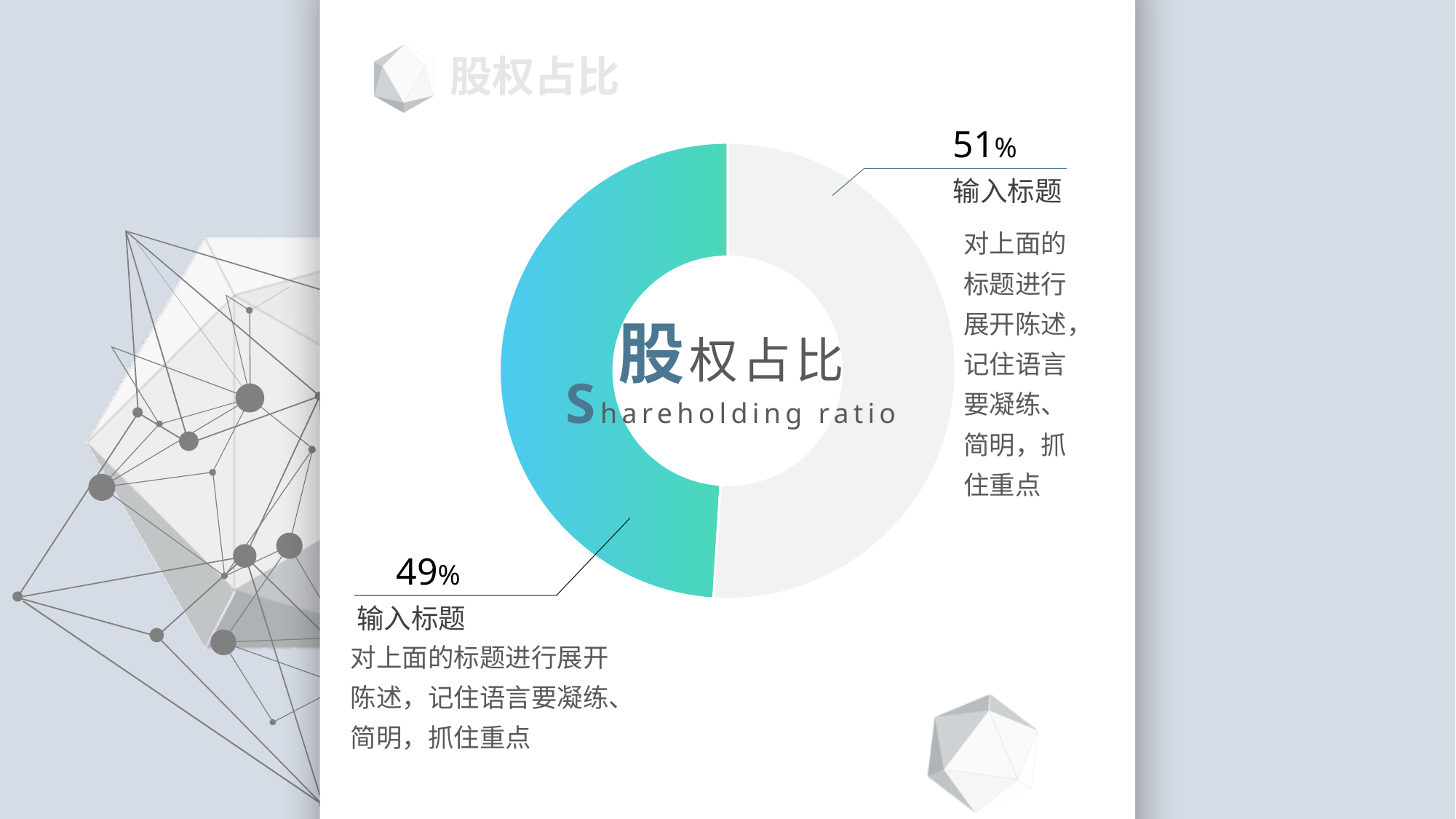
Which slice of the donut chart is larger, the grey one or the teal-blue one? The grey one What percentage is shown for the teal-blue slice on the left side of the donut chart? 49% What English text appears in the centre of the donut chart? Shareholding ratio What percentage is shown for the grey slice on the right side of the donut chart? 51% What is the difference between the two percentages shown in the donut chart? 2% What do the two percentages in the donut chart add up to? 100% What kind of chart is shown on the slide? Donut (pie) chart What is the Chinese title written in the centre of the donut chart? 股权占比 What is the largest share shown in the donut chart? 51% What is the smallest share shown in the donut chart? 49% How many slices does the donut chart have? 2